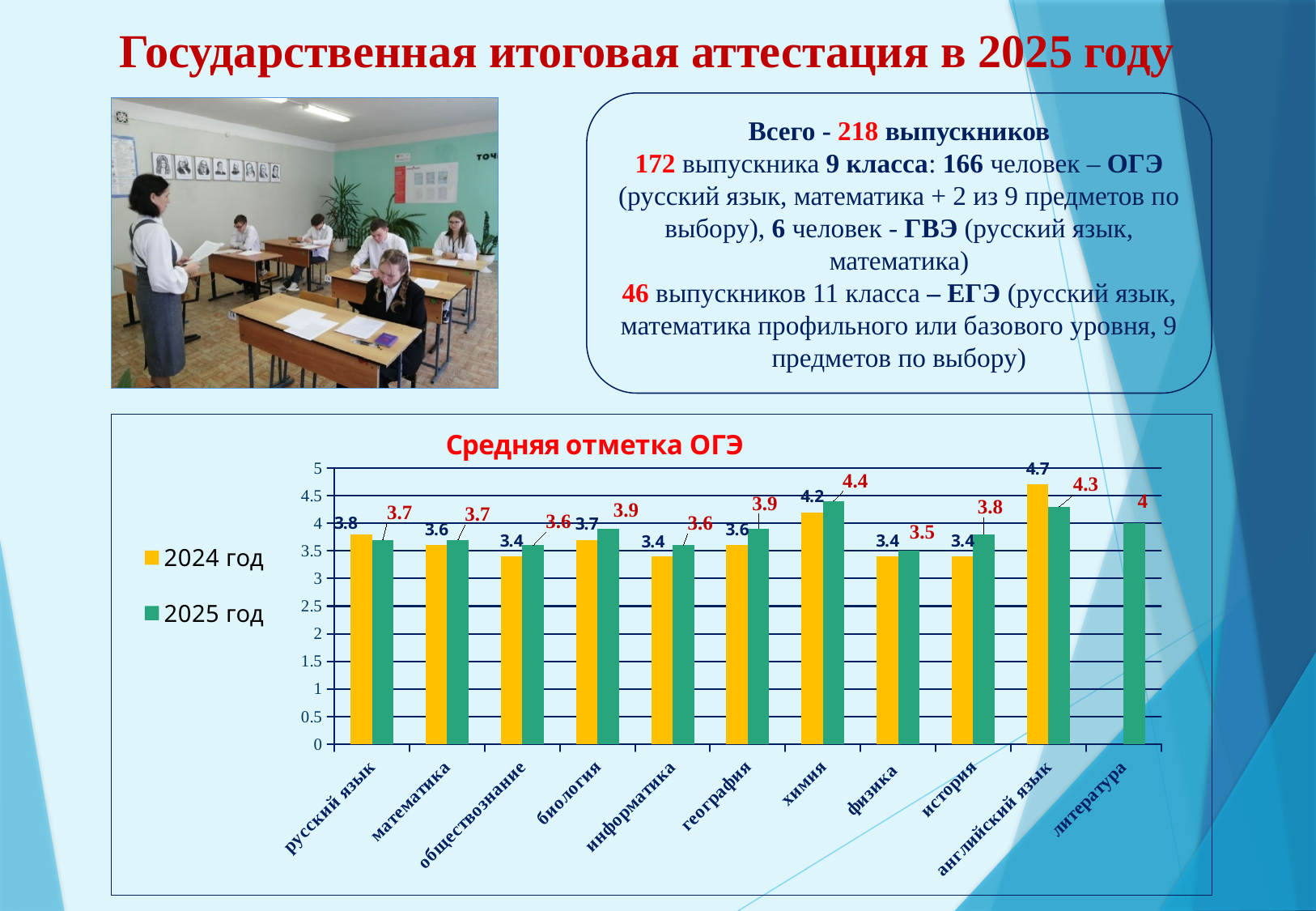
What is the title of the chart? Средняя отметка ОГЭ How many subject categories are shown on the x axis of the chart? 11 Is the 2025 год value for биология greater or less than 3.5? greater How many series does the chart legend list? 2 Which subject has the highest 2024 год value? английский язык What is the 2024 год value for английский язык? 4.7 What is the 2025 год value for литература? 4 What kind of chart is shown on the slide? bar chart What is the 2025 год value for химия? 4.4 Which is larger for русский язык: the 2024 год value or the 2025 год value? 2024 год What is the difference between the 2025 год and 2024 год values for история? 0.4 Which subject has the lowest 2025 год value? физика